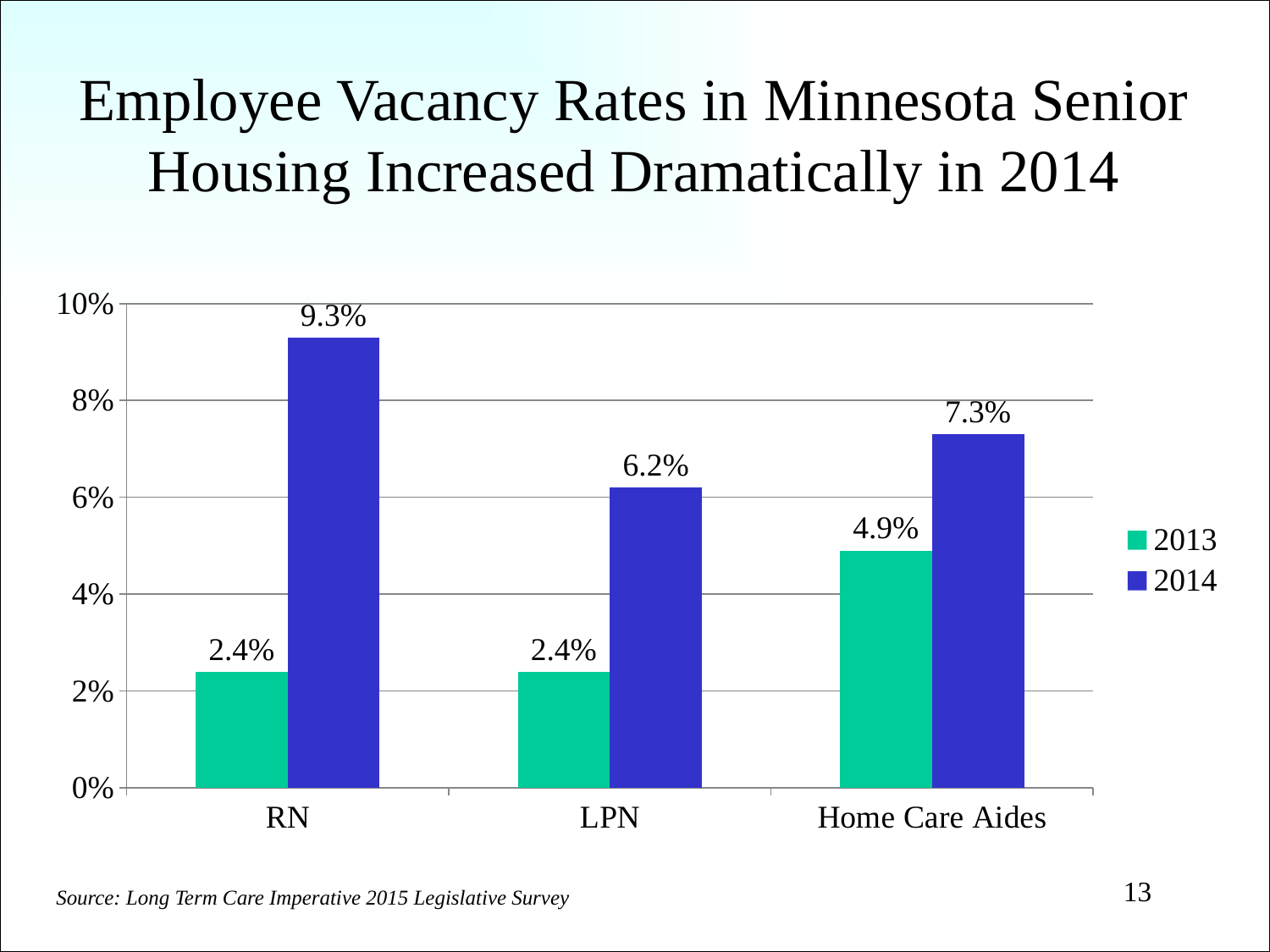
What was the vacancy rate for RN in 2014? 9.3% Which is larger: the 2014 vacancy rate for LPN or the 2013 vacancy rate for Home Care Aides? 2014 vacancy rate for LPN How many series does the legend list? 2 Which category had the highest vacancy rate in 2013? Home Care Aides What type of chart is shown on the slide? Bar chart By how many percentage points did the RN vacancy rate increase from 2013 to 2014? 6.9 percentage points What was the vacancy rate for Home Care Aides in 2013? 4.9% Which category had the lowest vacancy rate in 2014? LPN How many job categories are shown on the x axis? 3 What was the vacancy rate for LPN in 2014? 6.2% Which category had the highest vacancy rate in 2014? RN What is the difference between the 2014 vacancy rates for RN and Home Care Aides? 2.0 percentage points